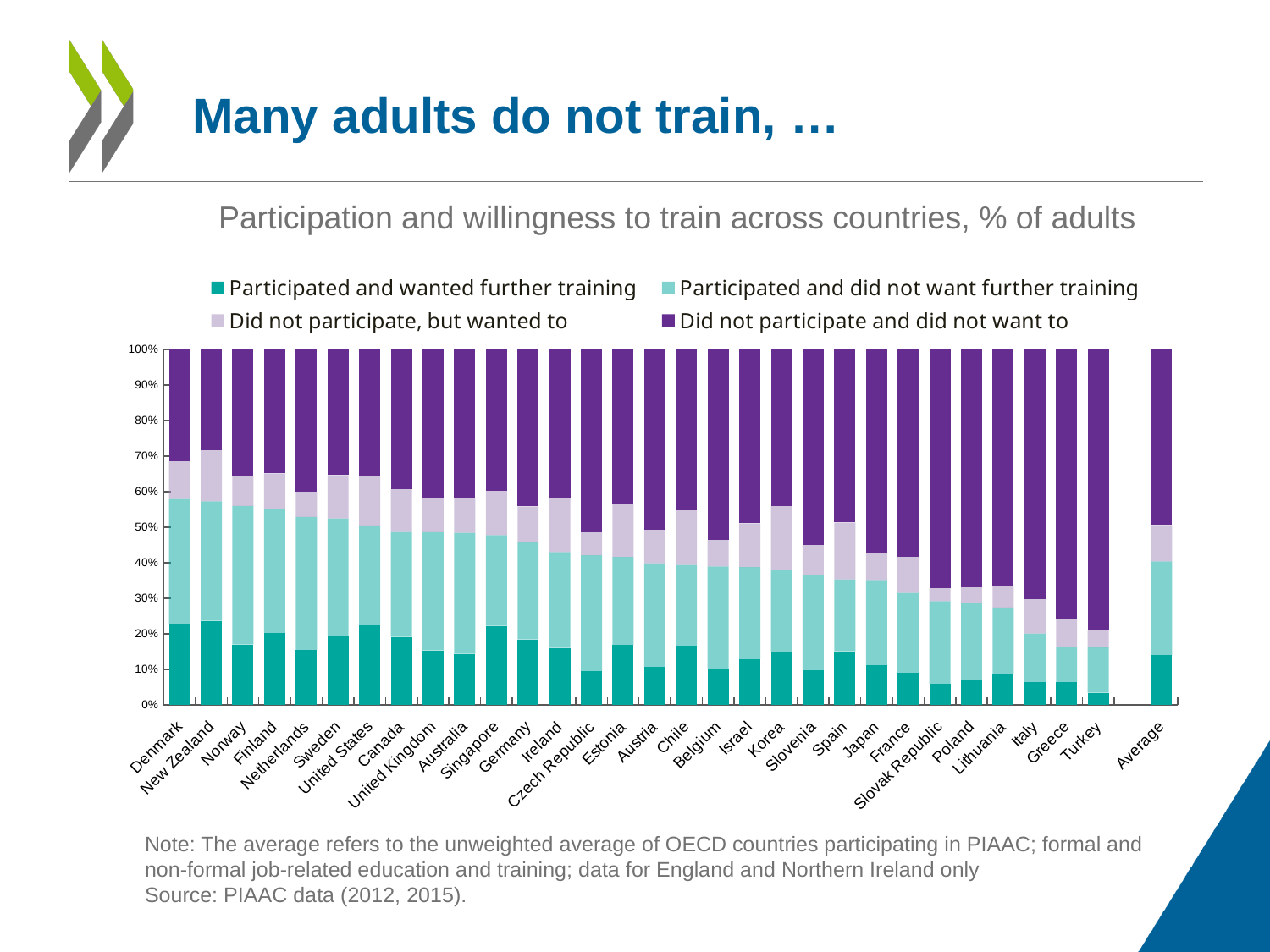
Which country has the smallest 'Participated and wanted further training' share? Turkey How many series does the legend list? 4 Does the 'Did not participate and did not want to' share rise or fall moving from Denmark on the left to Turkey on the right? Rise Is the 'Did not participate and did not want to' share for Turkey greater or less than 70%? greater How many countries are shown on the x axis, excluding the Average bar? 30 Which country has the largest 'Did not participate and did not want to' share? Turkey Is the 'Participated and wanted further training' value for Turkey greater or less than 10%? less Which category is plotted first on the left of the x axis? Denmark What is the title of the chart? Participation and willingness to train across countries, % of adults What kind of chart is shown on the slide? Stacked bar chart Which has the larger 'Participated and wanted further training' share, Denmark or Turkey? Denmark Is the 'Participated and wanted further training' value for Denmark greater or less than 20%? greater